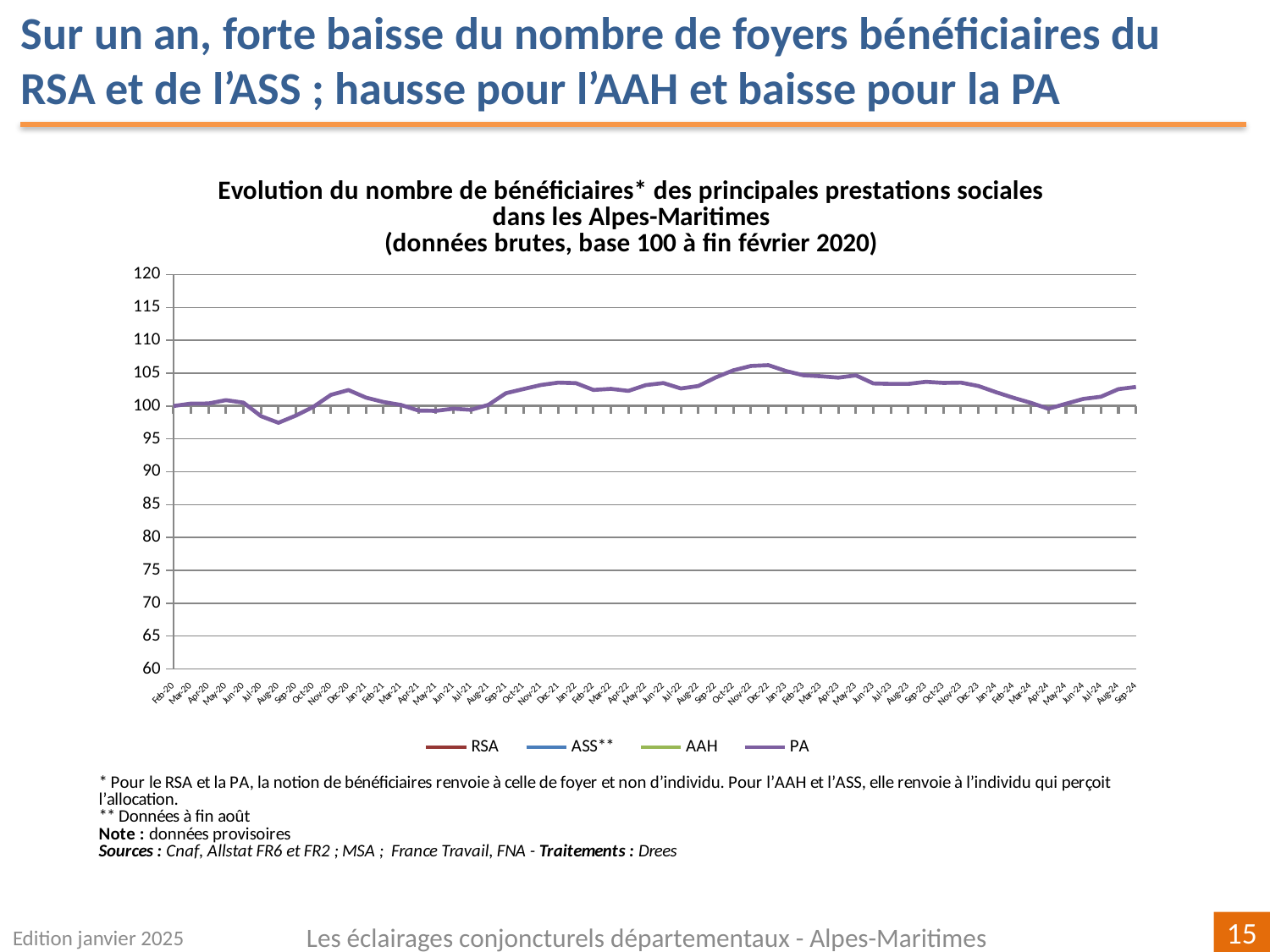
Is the value of the PA series in Dec-22 greater or less than 105? greater Does the PA series rise or fall between Aug-20 and Dec-22? rise Which series are listed in the chart legend? RSA, ASS**, AAH, PA What is the base period of the index (base 100) according to the chart title? fin février 2020 Which is larger for the PA series: the value in Dec-22 or the value in Aug-20? Dec-22 Does the PA series rise or fall between Dec-22 and Apr-24? fall What kind of chart is shown on the slide? line chart Is the value of the PA series in Jun-23 greater or less than 105? less Is the value of the PA series in Sep-24 greater or less than 100? greater In which month does the PA series reach its lowest value? Aug-20 How many series does the chart legend list? 4